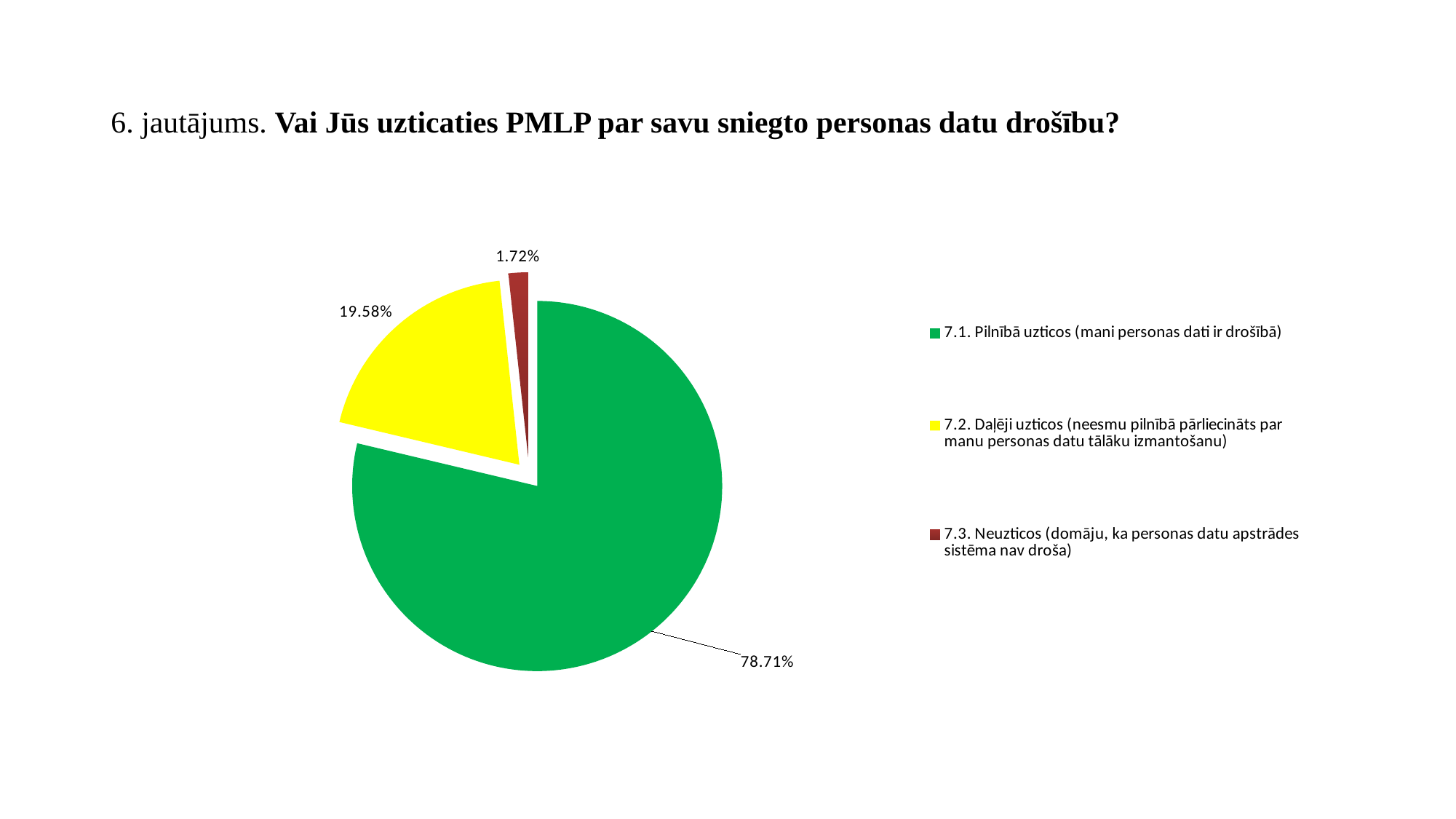
What colour is the slice for "7.3. Neuzticos"? dark red How many entries does the legend list? 3 What is the difference in percentage points between the "7.1. Pilnībā uzticos" slice and the "7.2. Daļēji uzticos" slice? 59.13 What share of the pie does "7.2. Daļēji uzticos" have? 19.58% What share of the pie does "7.3. Neuzticos" have? 1.72% Which category has the smallest slice of the pie? 7.3. Neuzticos (domāju, ka personas datu apstrādes sistēma nav droša) What kind of chart is shown on the slide? pie chart Which category has the largest slice of the pie? 7.1. Pilnībā uzticos (mani personas dati ir drošībā) Which is larger: the "7.2. Daļēji uzticos" slice or the "7.3. Neuzticos" slice? 7.2. Daļēji uzticos How many slices does the pie chart have? 3 What is the difference in percentage points between the "7.2. Daļēji uzticos" slice and the "7.3. Neuzticos" slice? 17.86 What share of the pie does "7.1. Pilnībā uzticos (mani personas dati ir drošībā)" have? 78.71%